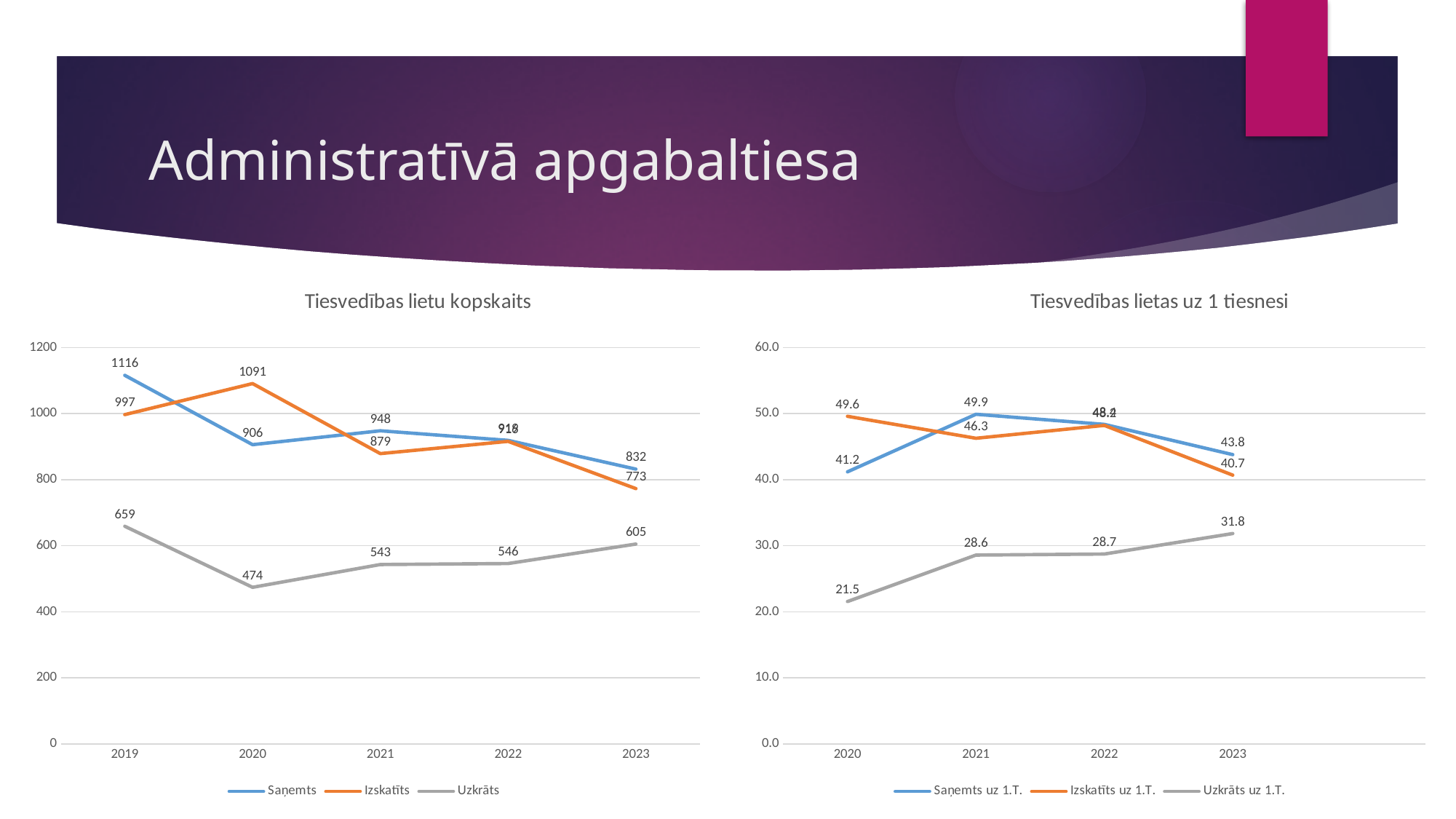
In the chart titled "Tiesvedības lietas uz 1 tiesnesi", in which year is Saņemts uz 1.T. highest? 2021 In the chart titled "Tiesvedības lietu kopskaits", what is the difference between Saņemts in 2019 and Saņemts in 2023? 284 In the chart titled "Tiesvedības lietu kopskaits", how many series does the legend list? 3 In the chart titled "Tiesvedības lietas uz 1 tiesnesi", how many years are shown on the x axis? 4 In the chart titled "Tiesvedības lietu kopskaits", what is the value of Saņemts in 2019? 1116 What kind of chart is the chart titled "Tiesvedības lietu kopskaits"? Line chart In the chart titled "Tiesvedības lietu kopskaits", is the value of Izskatīts in 2023 greater or less than 800? less In the chart titled "Tiesvedības lietas uz 1 tiesnesi", what is the value of Uzkrāts uz 1.T. in 2023? 31.8 In the chart titled "Tiesvedības lietu kopskaits", in which year is Uzkrāts lowest? 2020 In the chart titled "Tiesvedības lietas uz 1 tiesnesi", does Uzkrāts uz 1.T. rise or fall from 2020 to 2023? Rises In the chart titled "Tiesvedības lietu kopskaits", what is the value of Izskatīts in 2020? 1091 In the chart titled "Tiesvedības lietas uz 1 tiesnesi", which is larger in 2020: Saņemts uz 1.T. or Izskatīts uz 1.T.? Izskatīts uz 1.T.